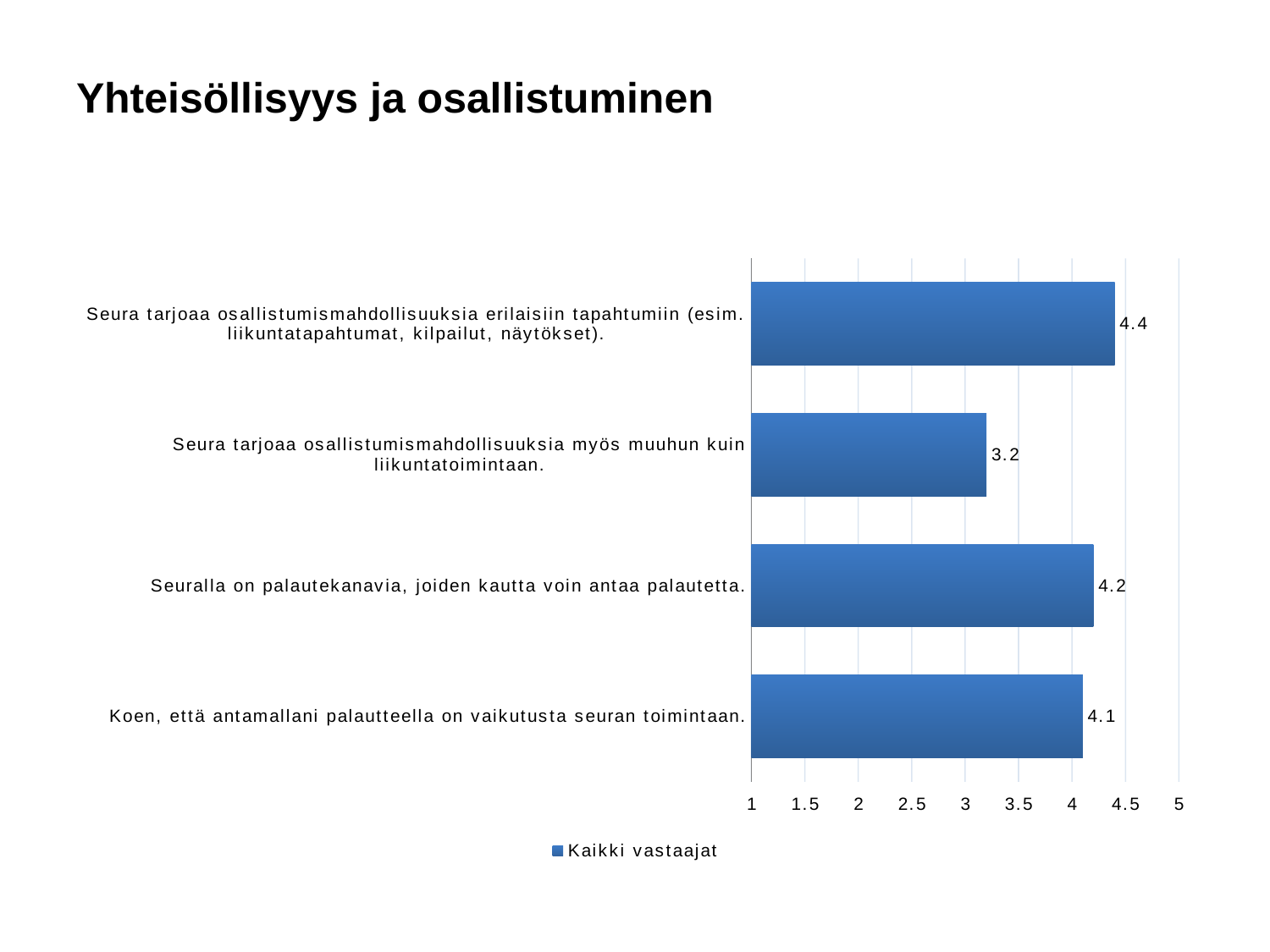
What is the value for "Seuralla on palautekanavia, joiden kautta voin antaa palautetta."? 4.2 How many categories are shown in the chart? 4 Which category has the highest value? Seura tarjoaa osallistumismahdollisuuksia erilaisiin tapahtumiin (esim. liikuntatapahtumat, kilpailut, näytökset). Which category has the lowest value? Seura tarjoaa osallistumismahdollisuuksia myös muuhun kuin liikuntatoimintaan. What is the value for "Seura tarjoaa osallistumismahdollisuuksia myös muuhun kuin liikuntatoimintaan."? 3.2 What is the value for "Koen, että antamallani palautteella on vaikutusta seuran toimintaan."? 4.1 How many series does the legend list? 1 What is the value for "Seura tarjoaa osallistumismahdollisuuksia erilaisiin tapahtumiin (esim. liikuntatapahtumat, kilpailut, näytökset)."? 4.4 Which is larger: the value for "Seuralla on palautekanavia, joiden kautta voin antaa palautetta." or the value for "Koen, että antamallani palautteella on vaikutusta seuran toimintaan."? Seuralla on palautekanavia, joiden kautta voin antaa palautetta. What kind of chart is shown on the slide? Bar chart Is the value for "Seura tarjoaa osallistumismahdollisuuksia myös muuhun kuin liikuntatoimintaan." greater or less than 3.5? less What is the difference between the highest value (4.4) and the lowest value (3.2)? 1.2